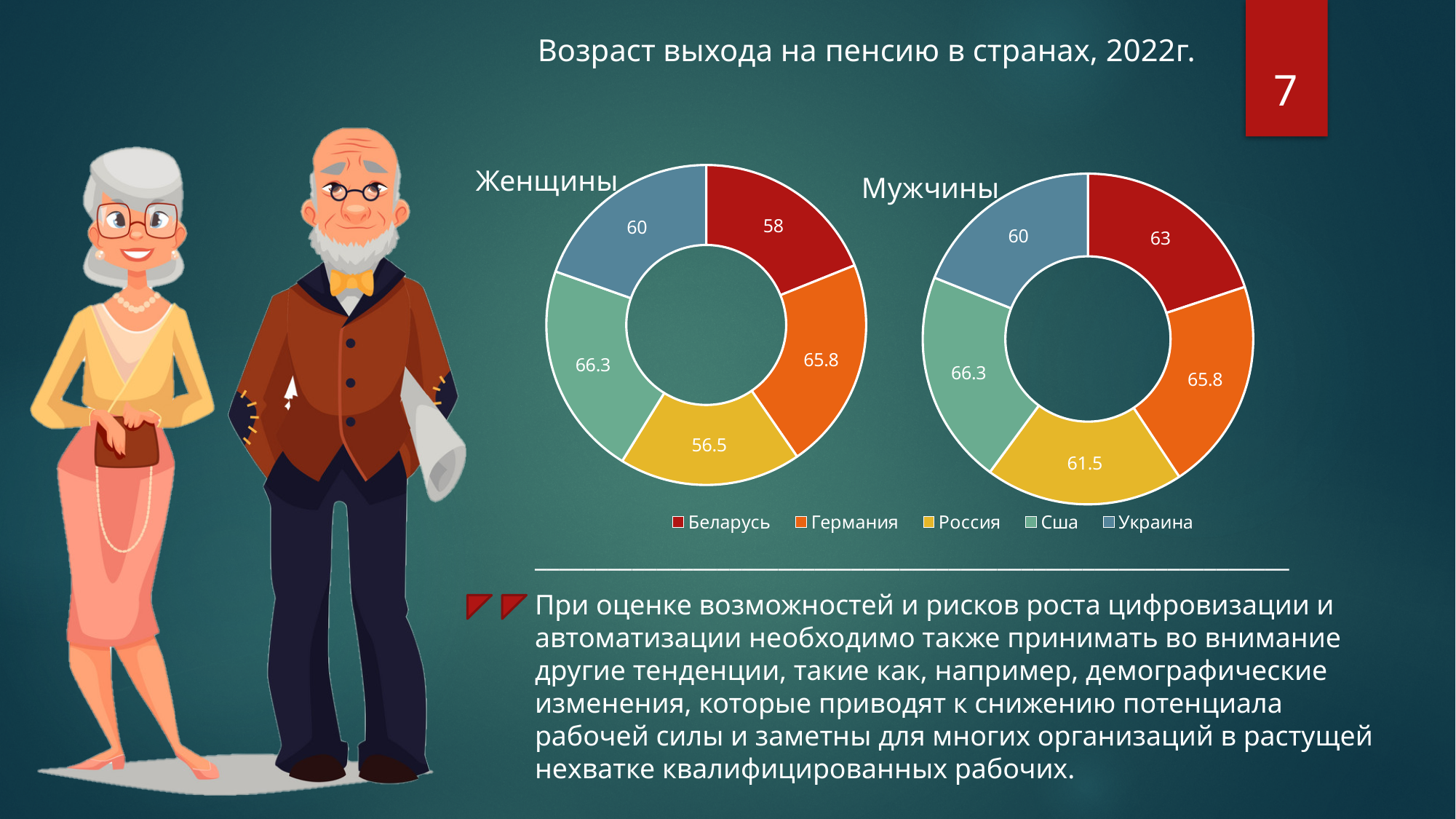
On the Женщины chart, which country has the lowest value? Россия On the Мужчины chart, which country has the lowest value? Украина How many countries are shown on the Женщины chart? 5 What kind of chart is the Мужчины chart? Doughnut chart What is the difference between the Беларусь values on the Мужчины chart and the Женщины chart? 5 On the Мужчины chart, which country has the highest value? Сша On the Женщины chart, which is larger: the value for Беларусь or the value for Россия? Беларусь On the Мужчины chart, what is the value for Германия? 65.8 On the Женщины chart, what is the value for Украина? 60 On the Мужчины chart, what is the value for Россия? 61.5 What is the title of the slide's charts? Возраст выхода на пенсию в странах, 2022г. On the Женщины chart, what is the value for Беларусь? 58